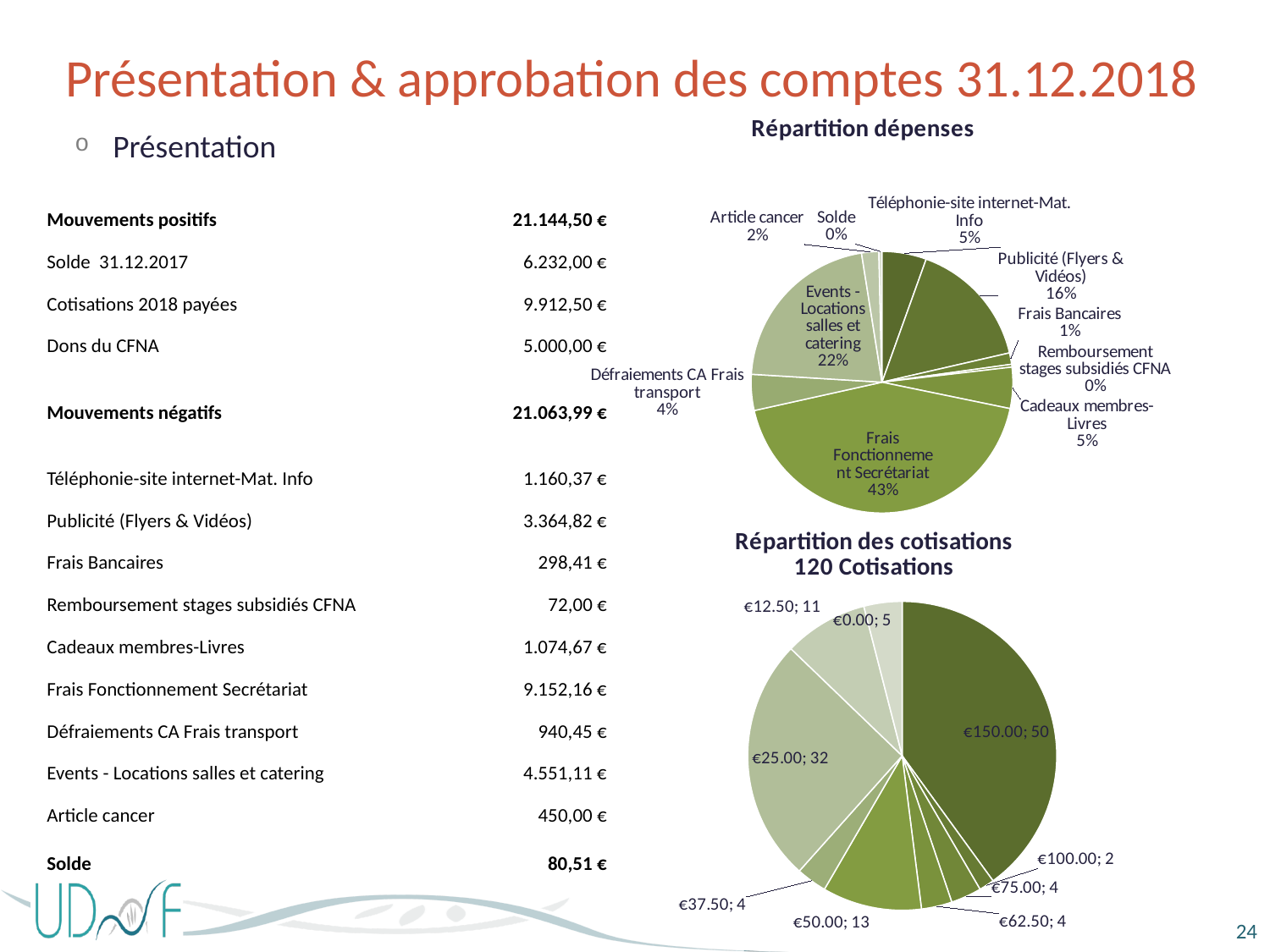
In the 'Répartition dépenses' pie chart, what share is shown for Events - Locations salles et catering? 22% In the 'Répartition dépenses' pie chart, which category has the largest share? Frais Fonctionnement Secrétariat What type of chart is 'Répartition des cotisations 120 Cotisations'? Pie chart In the 'Répartition dépenses' pie chart, what is the difference in percentage points between Frais Fonctionnement Secrétariat and Events - Locations salles et catering? 21 How many slices does the 'Répartition dépenses' pie chart have? 10 In the 'Répartition des cotisations' pie chart, how many cotisations are shown for €150.00? 50 In the 'Répartition dépenses' pie chart, what share is shown for Publicité (Flyers & Vidéos)? 16% In the 'Répartition dépenses' pie chart, which is larger: Cadeaux membres-Livres or Article cancer? Cadeaux membres-Livres In the 'Répartition dépenses' pie chart, what share is shown for Frais Fonctionnement Secrétariat? 43% In the 'Répartition des cotisations' pie chart, how many cotisations are shown for €25.00? 32 In the 'Répartition des cotisations' pie chart, what is the difference between the number of cotisations at €50.00 and at €12.50? 2 In the 'Répartition des cotisations' pie chart, which amount has the smallest number of cotisations? €100.00